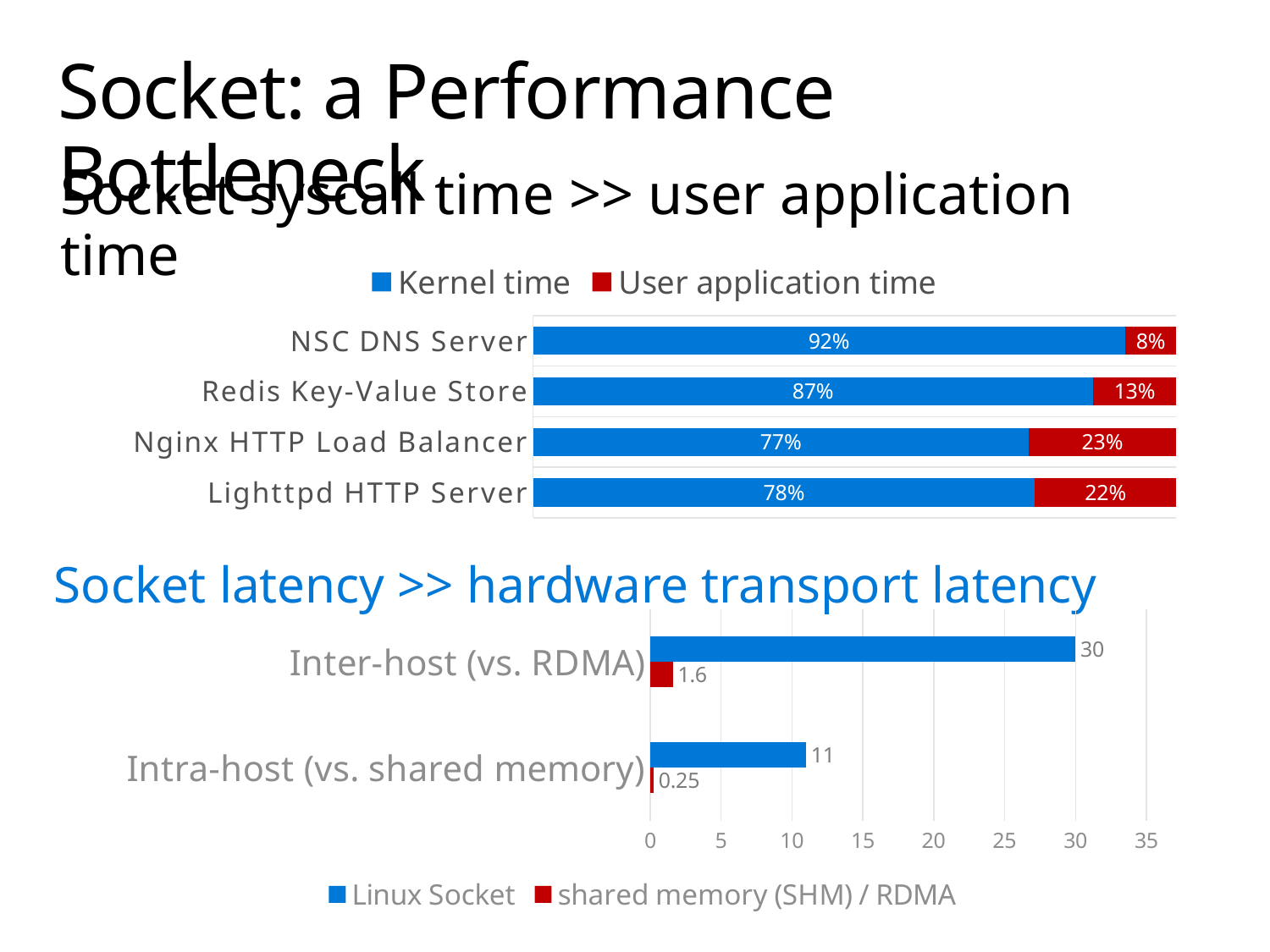
In the bottom chart, what is the Linux Socket value for Inter-host (vs. RDMA)? 30 In the top chart, what is the Kernel time value for NSC DNS Server? 92% In the top chart, which category has the lowest User application time? NSC DNS Server In the bottom chart, what is the difference between the Linux Socket and shared memory (SHM) / RDMA values for Inter-host (vs. RDMA)? 28.4 In the bottom chart, what is the shared memory (SHM) / RDMA value for Intra-host (vs. shared memory)? 0.25 In the top chart, what is the difference between the Kernel time of Redis Key-Value Store and Lighttpd HTTP Server? 9% In the top chart, what is the User application time value for Nginx HTTP Load Balancer? 23% In the bottom chart, which is larger: the Linux Socket value for Inter-host (vs. RDMA) or for Intra-host (vs. shared memory)? Inter-host (vs. RDMA) In the top chart, which category has the highest Kernel time? NSC DNS Server In the top chart, how many categories are shown? 4 In the top chart, how many series does the legend list? 2 What kind of chart is the bottom chart? Bar chart